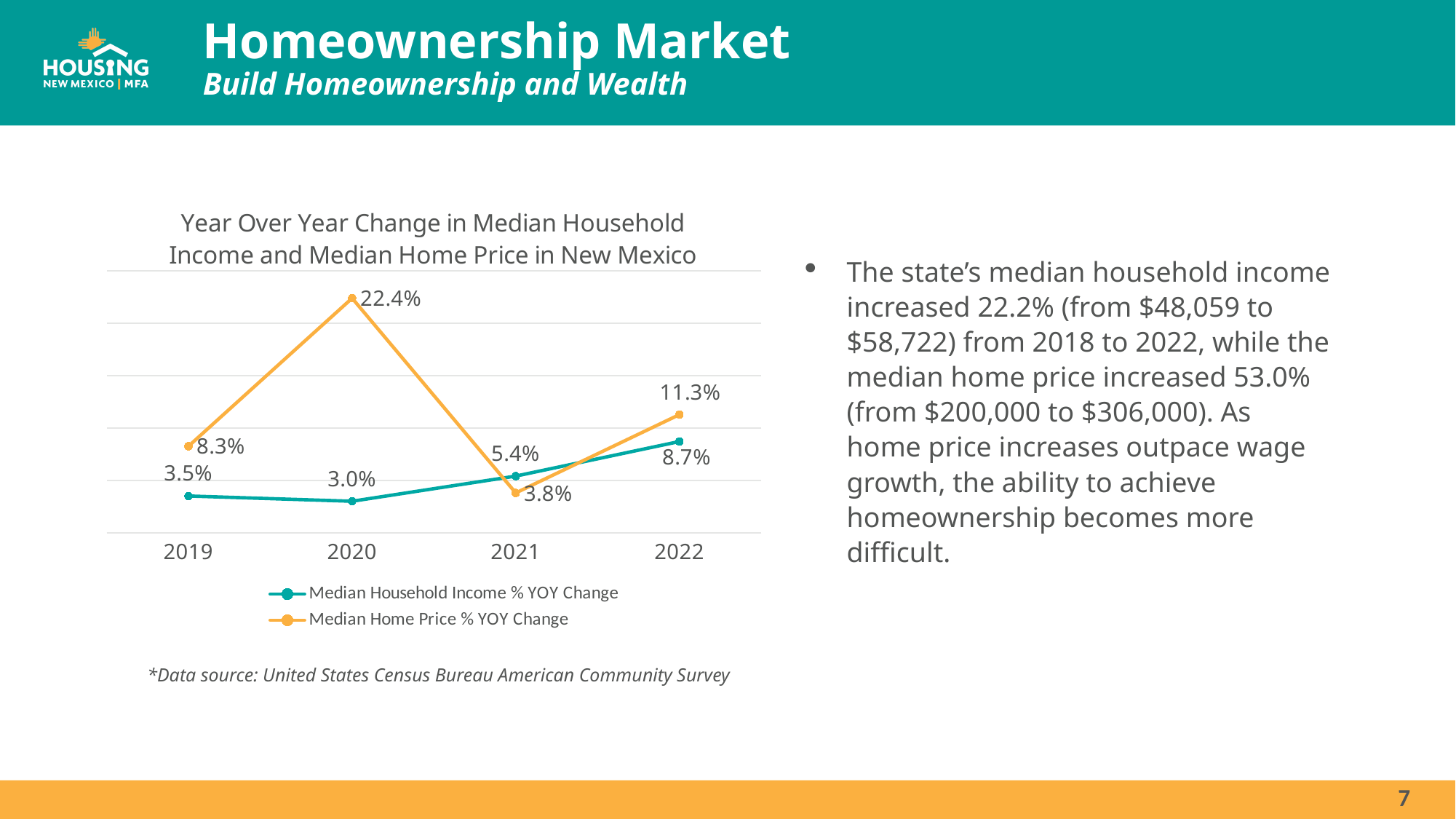
What is the title of the chart? Year Over Year Change in Median Household Income and Median Home Price in New Mexico How many series does the chart legend list? 2 What is the difference between the Median Home Price % YOY Change and the Median Household Income % YOY Change in 2020? 19.4% In which year is the Median Home Price % YOY Change highest? 2020 What is the Median Household Income % YOY Change for 2022? 8.7% Does the Median Household Income % YOY Change rise or fall from 2020 to 2022? Rise In which year is the Median Household Income % YOY Change lowest? 2020 What is the Median Home Price % YOY Change for 2021? 3.8% How many years are plotted on the x axis of the chart? 4 What is the Median Home Price % YOY Change for 2020? 22.4% In 2021, which series has the larger value: Median Household Income % YOY Change or Median Home Price % YOY Change? Median Household Income % YOY Change What kind of chart is shown on the slide? Line chart